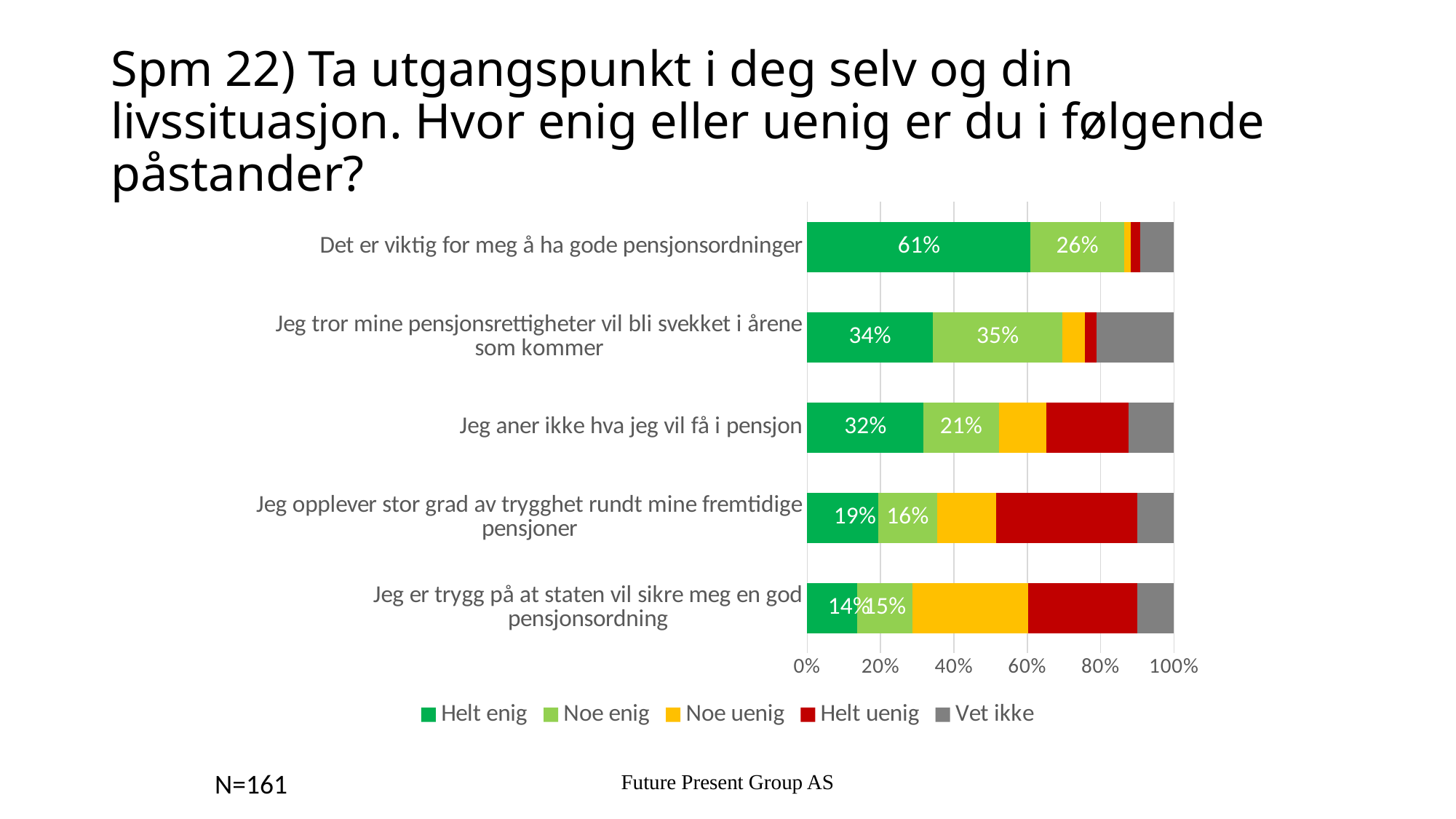
Which statement has the lowest 'Helt enig' value? Jeg er trygg på at staten vil sikre meg en god pensjonsordning How many statements (categories) are plotted in the chart? 5 Which is larger for 'Jeg aner ikke hva jeg vil få i pensjon': the 'Helt enig' value or the 'Noe enig' value? Helt enig What is the 'Noe enig' value for 'Jeg opplever stor grad av trygghet rundt mine fremtidige pensjoner'? 16% What is the 'Helt enig' value for 'Det er viktig for meg å ha gode pensjonsordninger'? 61% Which legend entry is shown in dark red? Helt uenig How many series does the legend list? 5 What is the difference between the 'Helt enig' values for 'Det er viktig for meg å ha gode pensjonsordninger' and 'Jeg tror mine pensjonsrettigheter vil bli svekket i årene som kommer'? 27% What is the 'Noe enig' value for 'Jeg tror mine pensjonsrettigheter vil bli svekket i årene som kommer'? 35% Which statement has the highest 'Helt enig' value? Det er viktig for meg å ha gode pensjonsordninger What is the 'Helt enig' value for 'Jeg aner ikke hva jeg vil få i pensjon'? 32% What type of chart is shown on the slide? Stacked bar chart